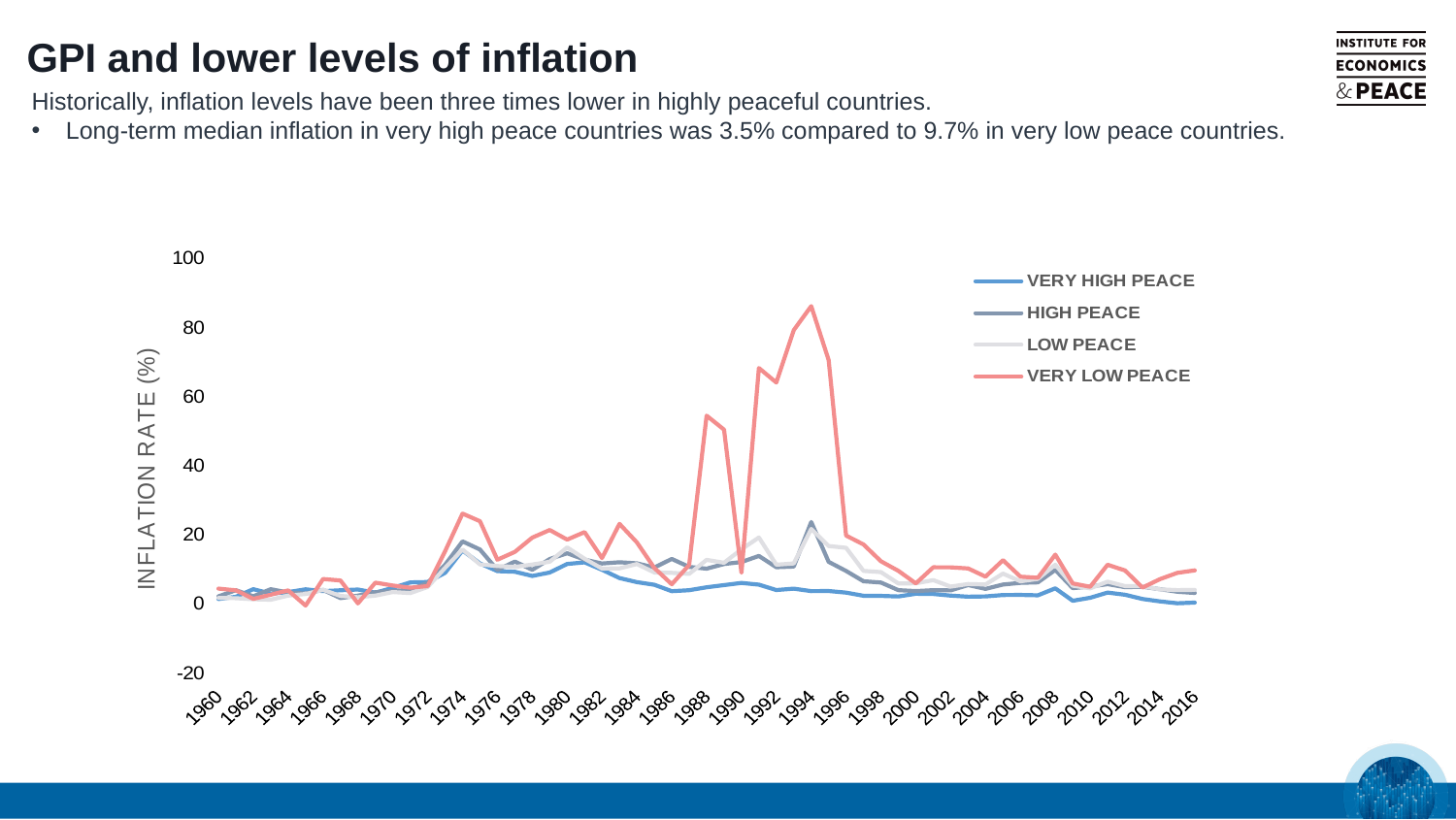
What is the first year shown on the x axis? 1960 How many series does the legend list? 4 Which series reaches the highest inflation rate on the chart? VERY LOW PEACE What kind of chart is shown on the slide? line chart Is the value for VERY HIGH PEACE in 2016 greater or less than 20? less What is the label of the y axis? INFLATION RATE (%) Does the VERY LOW PEACE line rise or fall between 1994 and 1996? fall Is the value for VERY LOW PEACE in 1994 greater or less than 60? greater Is the value for VERY LOW PEACE in 1988 greater or less than 40? greater Which series has the lowest value in 2016? VERY HIGH PEACE In 1994, which is larger: the value for VERY LOW PEACE or the value for VERY HIGH PEACE? VERY LOW PEACE